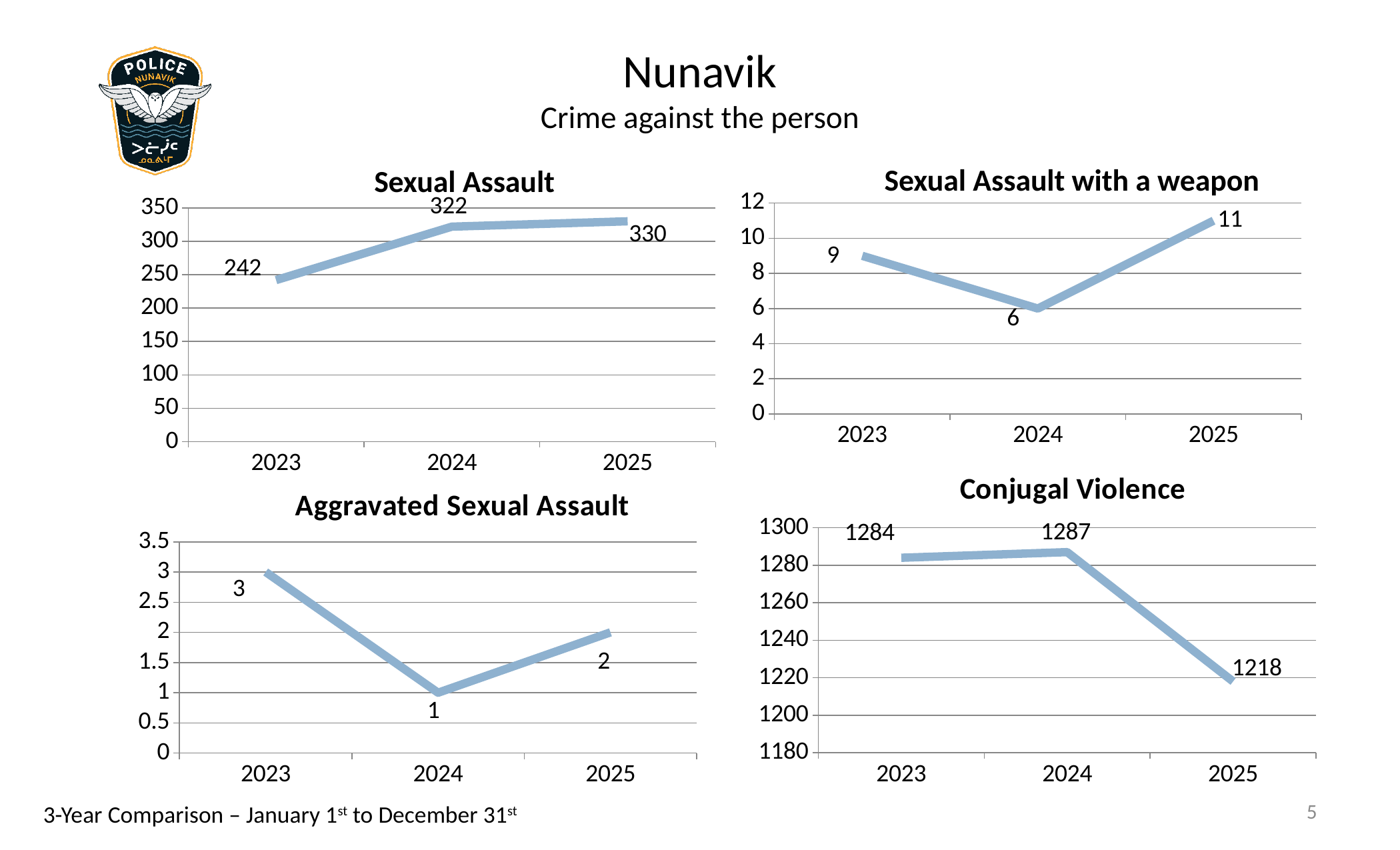
In the Sexual Assault with a weapon chart, which year has the highest value? 2025 In the Conjugal Violence chart, what is the value for 2025? 1218 In the Sexual Assault with a weapon chart, is the value for 2023 larger or smaller than the value for 2025? smaller In the Conjugal Violence chart, what is the difference between the 2024 and 2025 values? 69 In the Aggravated Sexual Assault chart, which year has the lowest value? 2024 In the Sexual Assault chart, what is the value for 2024? 322 In the Aggravated Sexual Assault chart, what is the value for 2023? 3 In the Sexual Assault with a weapon chart, what is the value for 2024? 6 In the Sexual Assault chart, which year has the lowest value? 2023 In the Sexual Assault chart, what is the difference between the 2025 and 2023 values? 88 What type of chart is the Sexual Assault chart? line chart How many data points does the Conjugal Violence chart show? 3